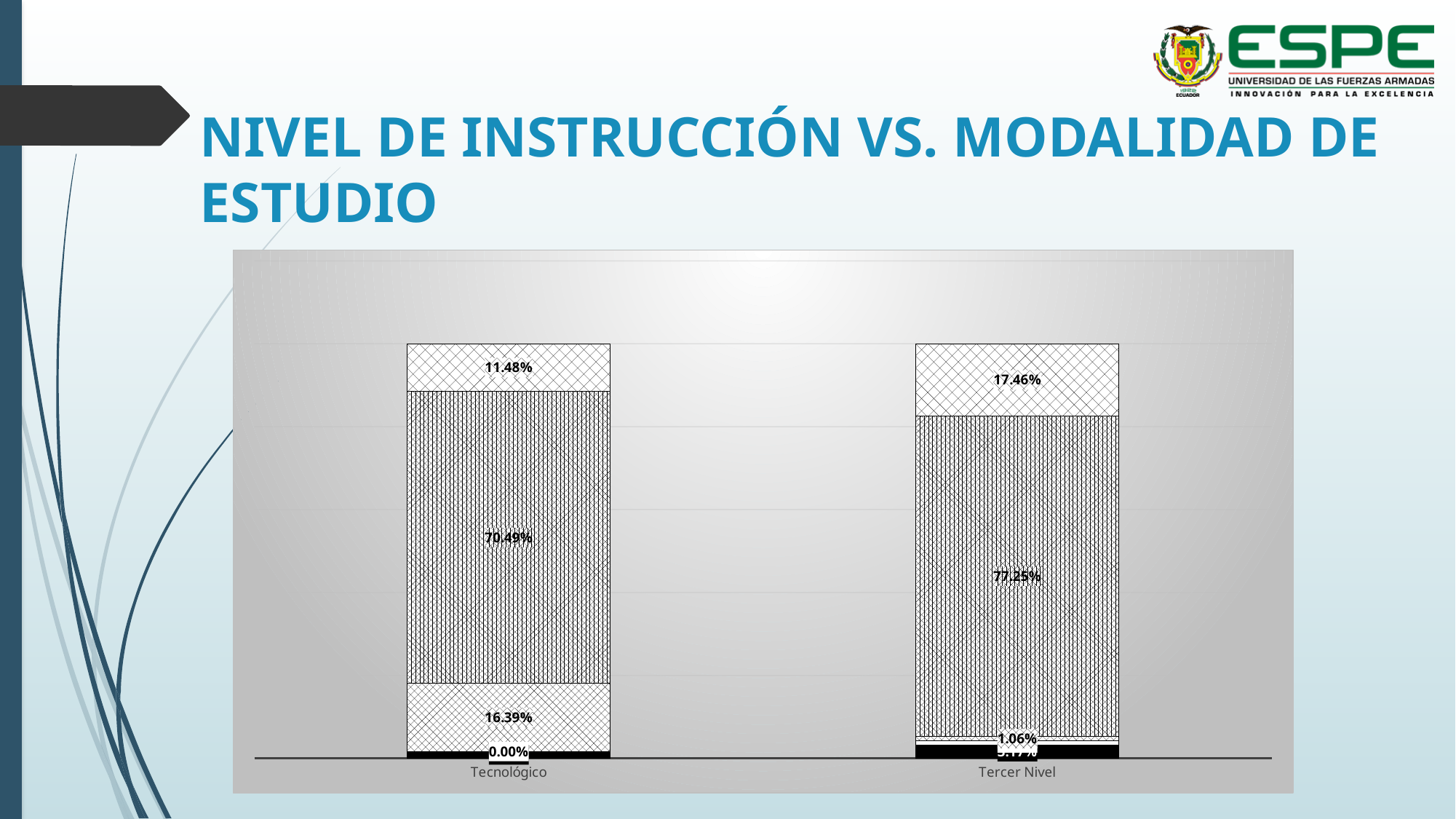
What kind of chart is shown on the slide? stacked bar chart What is the value of the largest segment of the Tecnológico bar? 70.49% What is the difference between the largest segment of Tercer Nivel (77.25%) and the largest segment of Tecnológico (70.49%)? 6.76% What is the value of the top segment of the Tecnológico bar? 11.48% Which bar has the larger top segment, Tecnológico or Tercer Nivel? Tercer Nivel How many categories are shown on the x axis of the chart? 2 What is the title of the slide containing the chart? NIVEL DE INSTRUCCIÓN VS. MODALIDAD DE ESTUDIO What is the value of the second segment from the bottom of the Tercer Nivel bar? 1.06% What is the value of the top segment of the Tercer Nivel bar? 17.46% What is the value of the largest segment of the Tercer Nivel bar? 77.25% What is the value of the second segment from the bottom of the Tecnológico bar? 16.39%